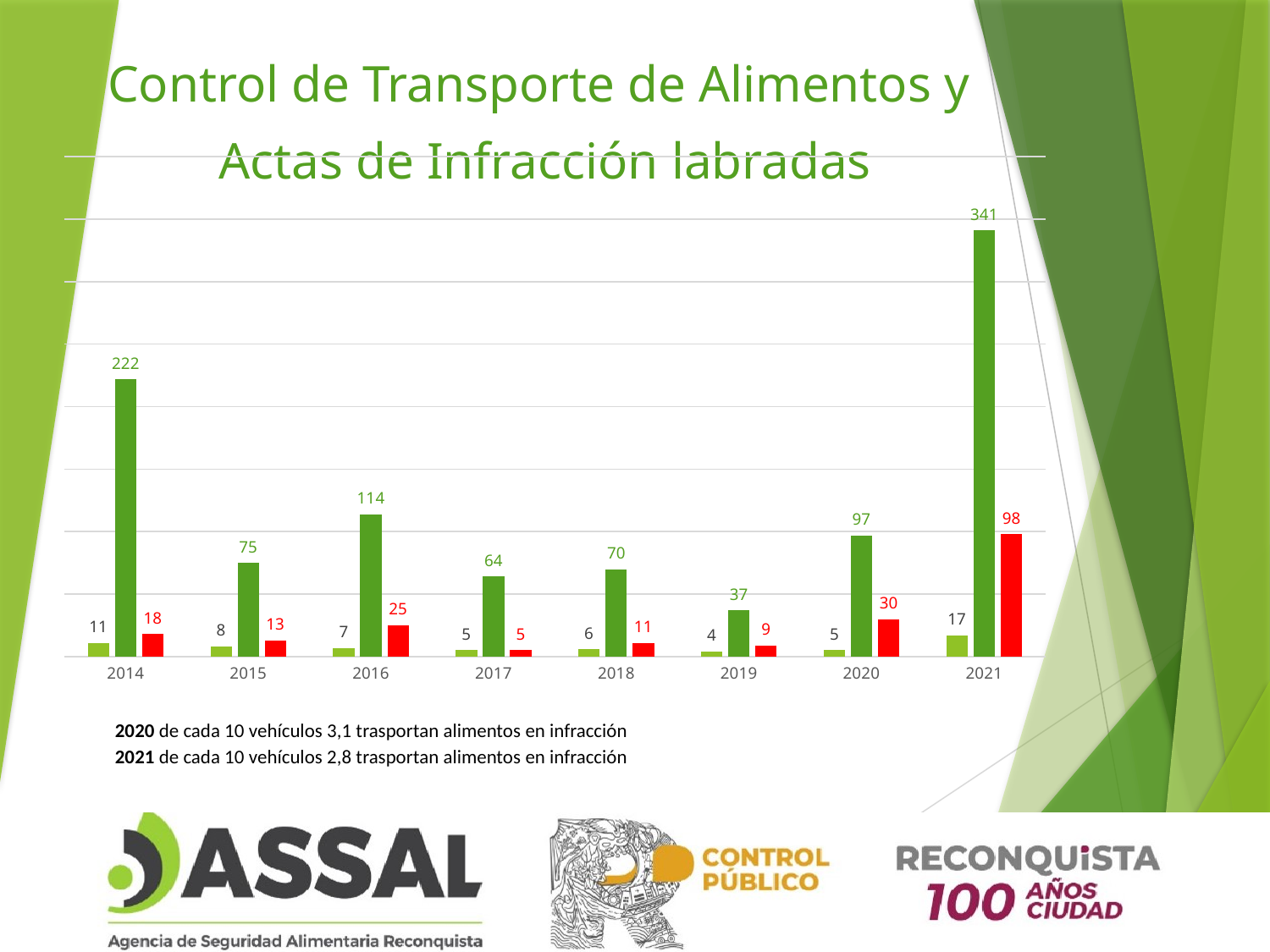
Does the dark green bar rise or fall from 2019 to 2021? rise How many years are shown along the x axis of the chart? 8 Which is larger, the red bar for 2020 or the red bar for 2015? 2020 In which year is the red bar the lowest? 2017 In which year is the light green bar the lowest? 2019 What is the value of the dark green bar for 2021? 341 What type of chart is shown on the slide? bar chart What is the value of the red bar for 2016? 25 What is the difference between the dark green bar values for 2021 and 2014? 119 What is the value of the light green bar for 2021? 17 In which year is the dark green bar the highest? 2021 What is the title of the chart on the slide? Control de Transporte de Alimentos y Actas de Infracción labradas